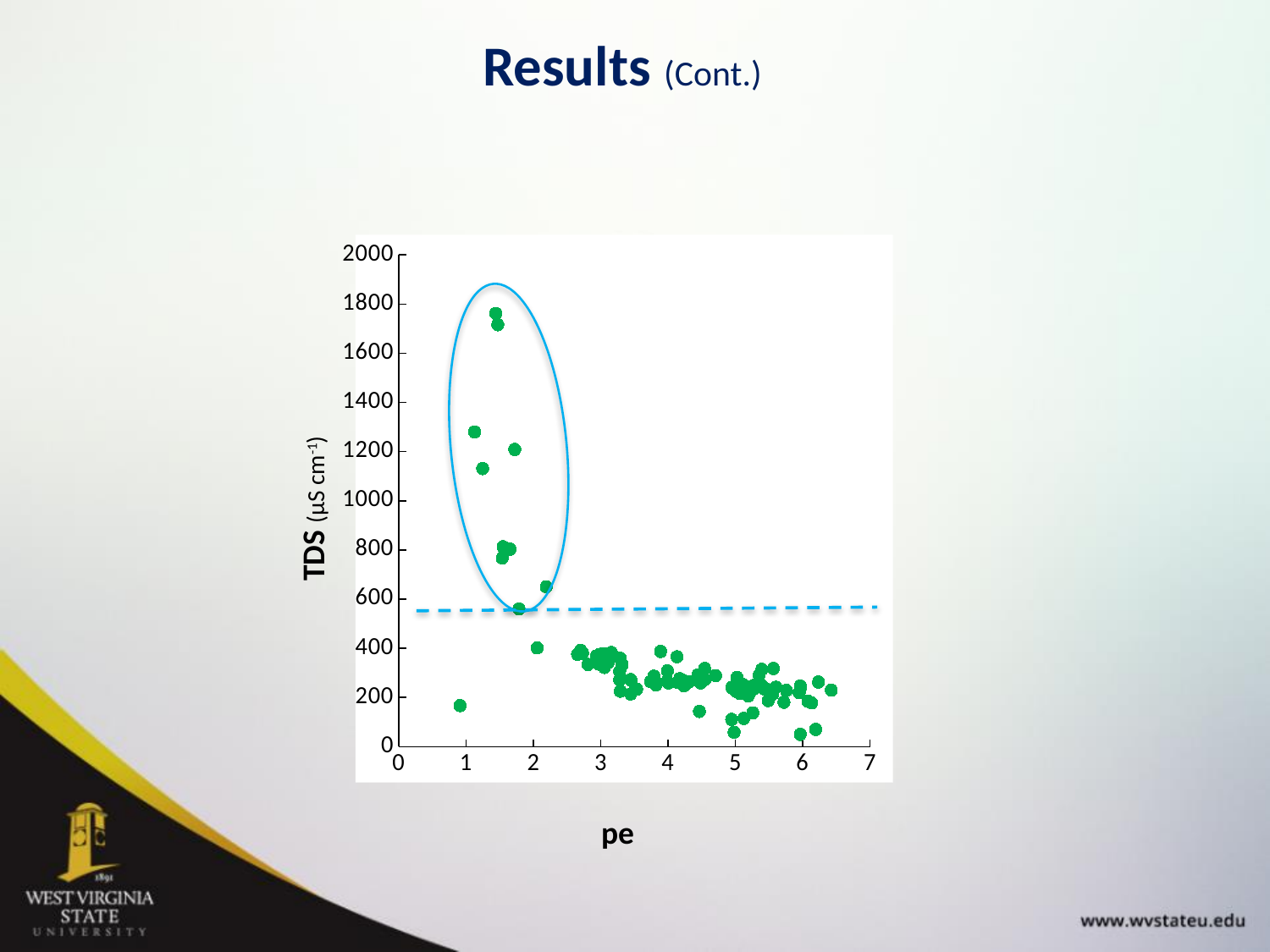
Are the points with TDS above 1000 found at pe values greater or less than 3? less Is the highest TDS value plotted greater or less than 1600? greater Is the lowest TDS value plotted greater or less than 200? less What is the label of the x axis of the chart? pe What is the maximum value shown on the x axis of the chart? 7 What quantity is plotted on the y axis of the chart? TDS (µS cm-1) As pe increases along the x axis, do the TDS values generally rise or fall? fall What kind of chart is shown on the slide? scatter plot